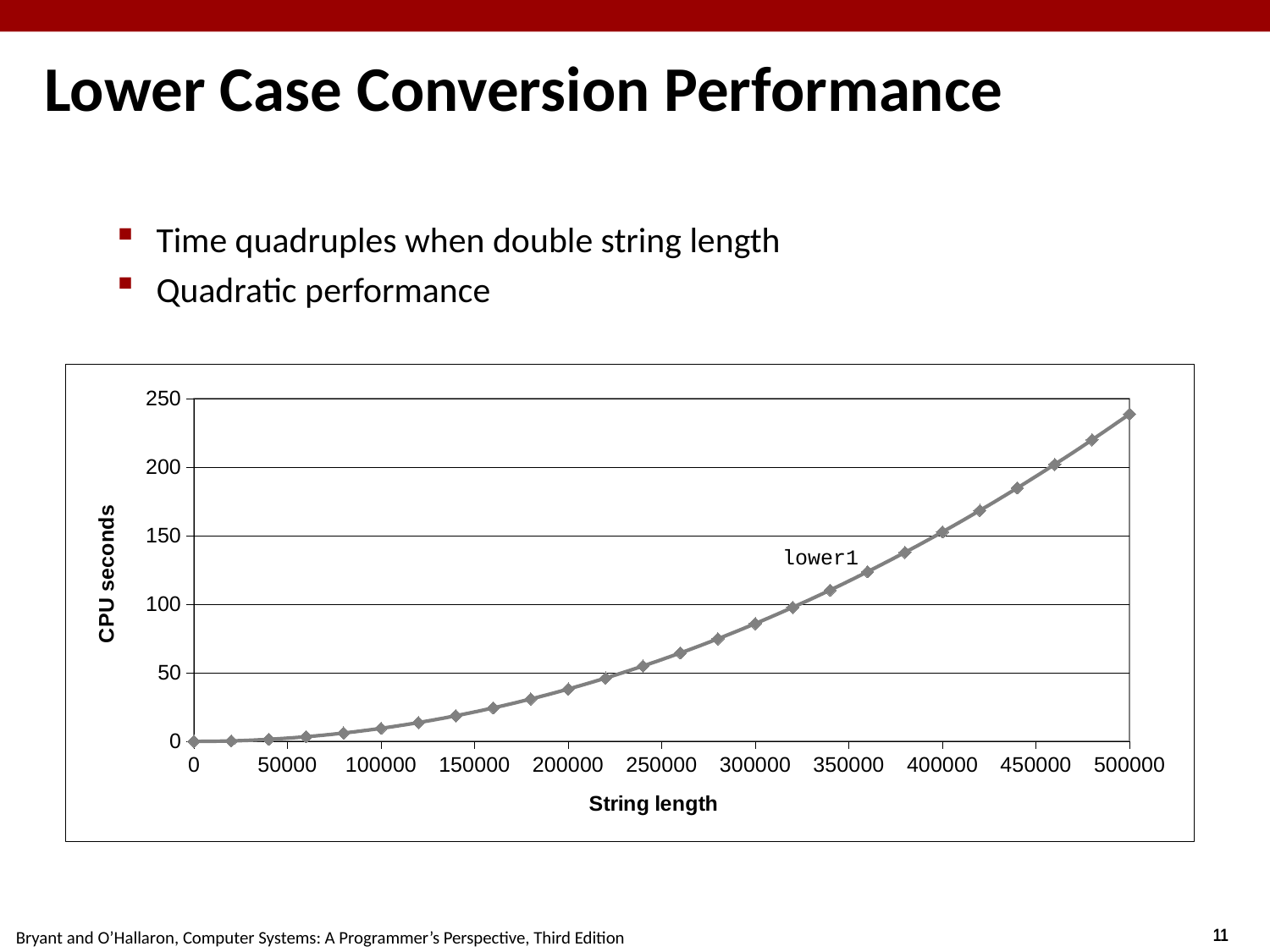
Is the CPU seconds value at string length 400000 greater or less than 100? greater How many data points are plotted on the line? 26 Is the CPU seconds value at string length 200000 greater or less than 50? less Do the CPU seconds rise or fall as string length increases? rise At which string length is the CPU time highest? 500000 What is the label on the y axis of the chart? CPU seconds Is the CPU seconds value at string length 300000 greater or less than 100? less What is the label on the x axis of the chart? String length At which string length is the CPU time lowest? 0 Which has the larger CPU time, string length 100000 or string length 400000? 400000 What kind of chart is shown on the slide? line chart